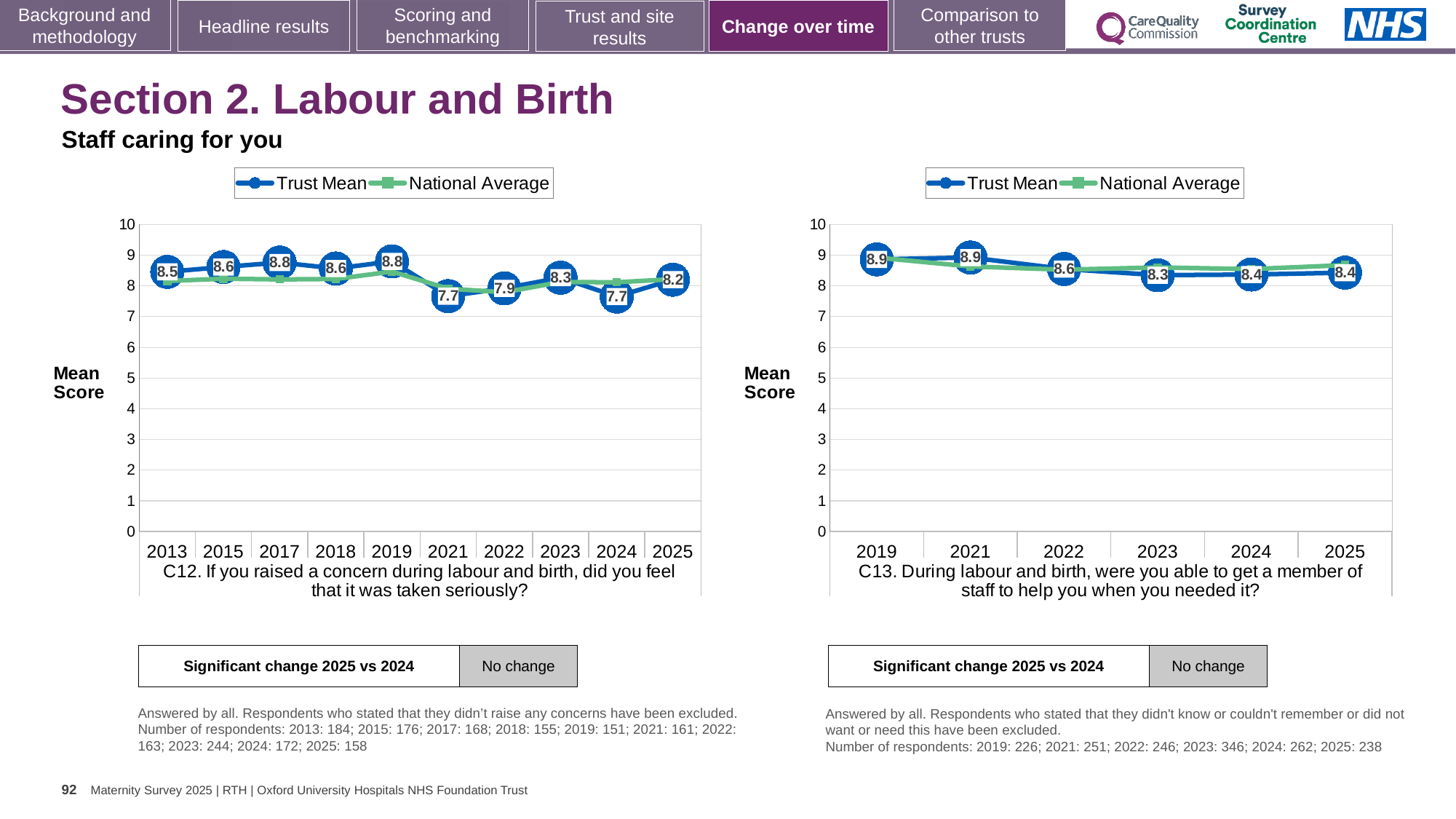
In the C13 chart on the right, which year has the lowest Trust Mean score? 2023 In the C13 chart on the right, what is the Trust Mean score for 2023? 8.3 In the C12 chart on the left, what is the Trust Mean score for 2021? 7.7 How many series does the legend of the C13 chart on the right list? 2 In the C12 chart on the left, what is the Trust Mean score for 2025? 8.2 How many years are plotted on the x axis of the C12 chart on the left? 10 In the C13 chart on the right, what is the Trust Mean score for 2019? 8.9 In the C12 chart on the left, what is the difference between the Trust Mean scores for 2019 and 2021? 1.1 In the C12 chart on the left, is the Trust Mean score higher in 2023 or in 2024? 2023 What kind of chart is the C12 chart on the left? Line chart In the C13 chart on the right, is the National Average for 2025 greater or less than 8? greater In the C13 chart on the right, what is the difference between the Trust Mean scores for 2019 and 2025? 0.5